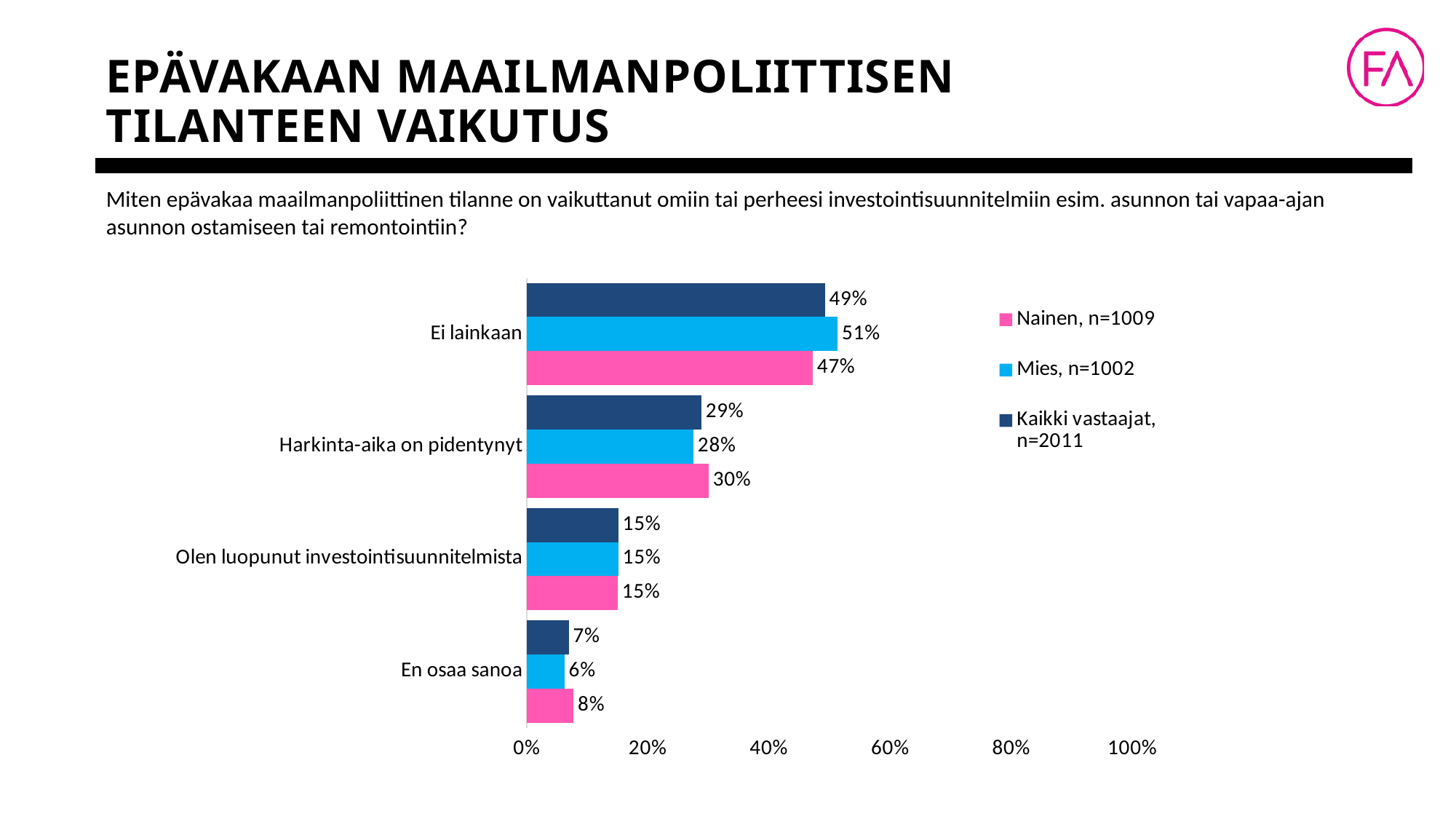
What is the value for Nainen in the Harkinta-aika on pidentynyt category? 30% How many categories are shown on the chart? 4 What is the difference between the Mies and Nainen values in the Ei lainkaan category? 4% How many series does the legend list? 3 What kind of chart is shown on the slide? bar chart Is the value for Kaikki vastaajat in the Ei lainkaan category greater or less than 40%? greater What is the sample size (n) for the Mies series according to the legend? 1002 Which category has the highest value for Kaikki vastaajat? Ei lainkaan Which category has the lowest value for Nainen? En osaa sanoa Which is larger in the Harkinta-aika on pidentynyt category, the Nainen value or the Mies value? Nainen What is the value for Kaikki vastaajat in the En osaa sanoa category? 7% What is the value for Mies in the Ei lainkaan category? 51%